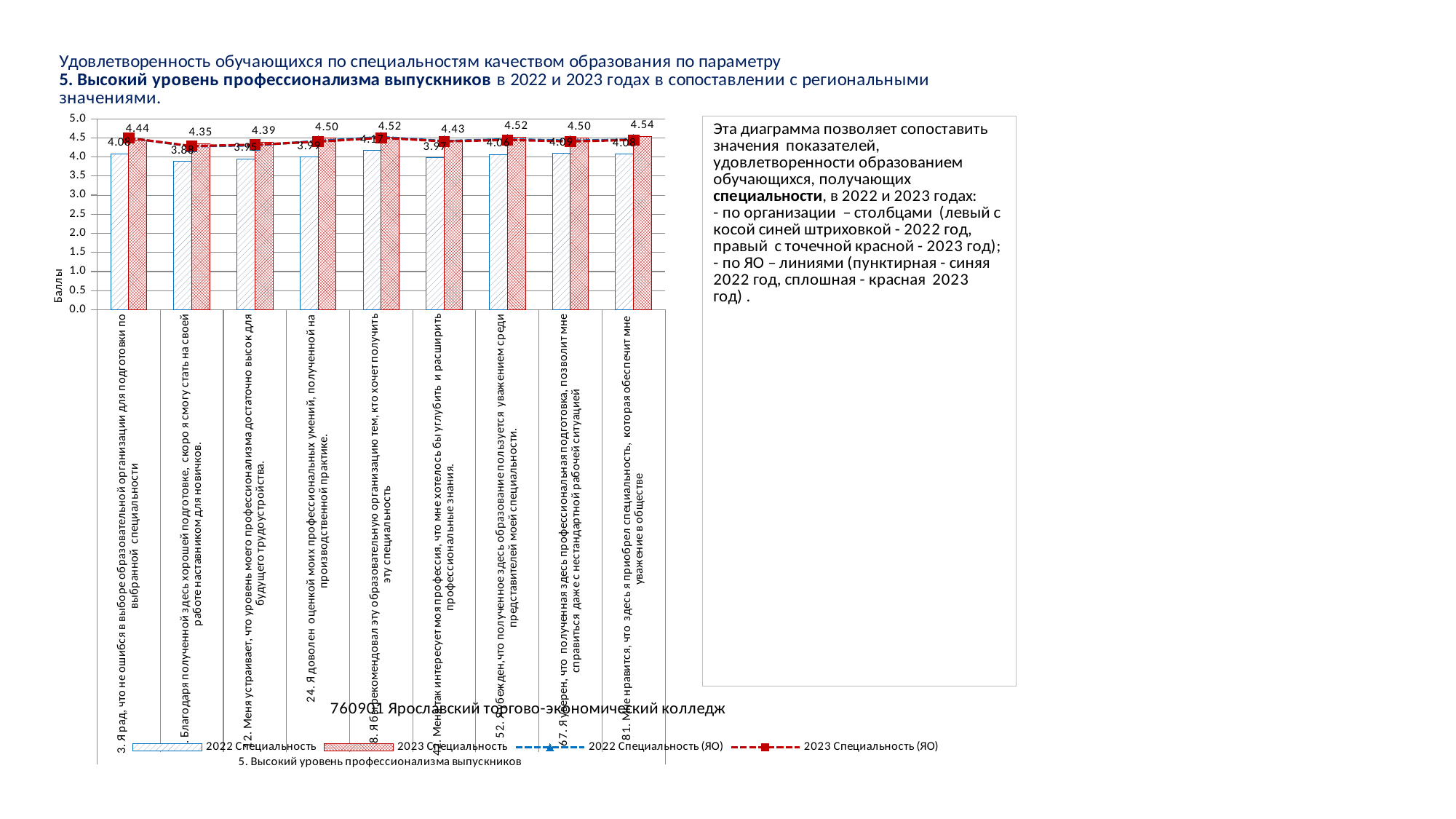
Is the 2022 Специальность value for the statement "Благодаря полученной здесь хорошей подготовке..." greater or less than 4.0? less Which has a higher 2023 Специальность value: statement 8 ("Я бы рекомендовал эту образовательную организацию...") or statement 2 ("Меня устраивает, что уровень моего профессионализма...")? Statement 8 Which statement has the lowest 2023 Специальность value? Благодаря полученной здесь хорошей подготовке, скоро я смогу стать на своей работе наставником для новичков What is the title of the vertical axis of the chart? Баллы What is the difference between the highest (4.54) and lowest (4.35) 2023 Специальность values? 0.19 How many statements (categories) are shown on the x axis of the chart? 9 What is the value of the 2023 Специальность bar for statement 81 ("Мне нравится, что здесь я приобрел специальность, которая обеспечит мне уважение в обществе")? 4.54 What kind of chart is shown on the slide? A combined bar and line chart How many series does the chart legend list? 4 Which statement has the highest 2023 Специальность value? 81. Мне нравится, что здесь я приобрел специальность, которая обеспечит мне уважение в обществе What is the value of the 2023 Специальность bar for statement 24 ("Я доволен оценкой моих профессиональных умений, полученной на производственной практике")? 4.50 What is the value of the 2023 Специальность bar for statement 2 ("Меня устраивает, что уровень моего профессионализма достаточно высок для будущего трудоустройства")? 4.39